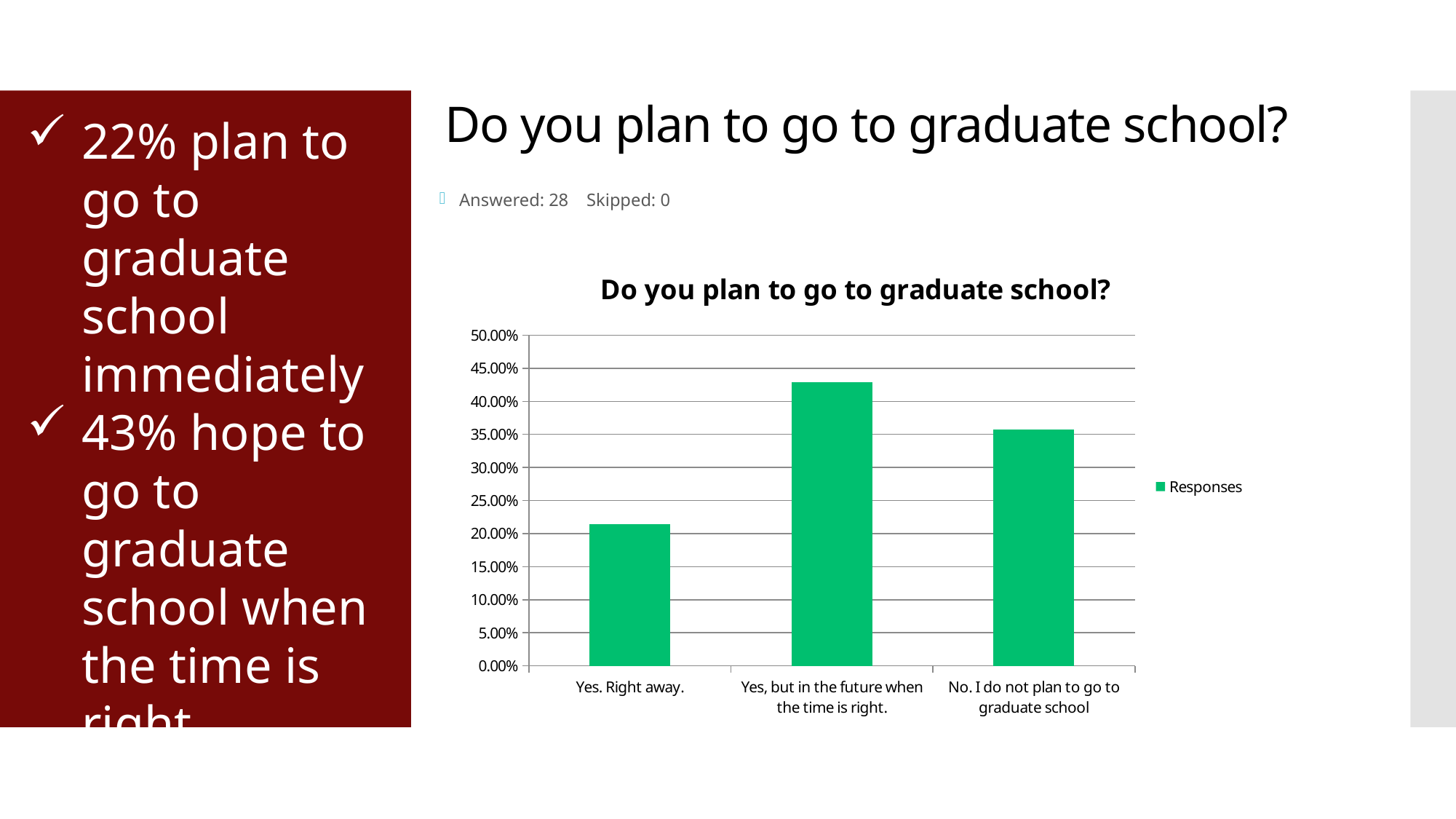
Which is larger: the value for "No. I do not plan to go to graduate school" or the value for "Yes. Right away."? No. I do not plan to go to graduate school Is the value for "No. I do not plan to go to graduate school" greater or less than 30.00%? greater Which category has the lowest bar in the chart? Yes. Right away. What kind of chart is shown on the slide? bar chart Is the value for "No. I do not plan to go to graduate school" greater or less than 40.00%? less What is the name of the series listed in the chart legend? Responses Which category has the highest bar in the chart? Yes, but in the future when the time is right. Is the value for "Yes, but in the future when the time is right." greater or less than 40.00%? greater How many series does the chart legend list? 1 How many categories are shown on the x axis of the chart? 3 What is the title of the chart? Do you plan to go to graduate school?